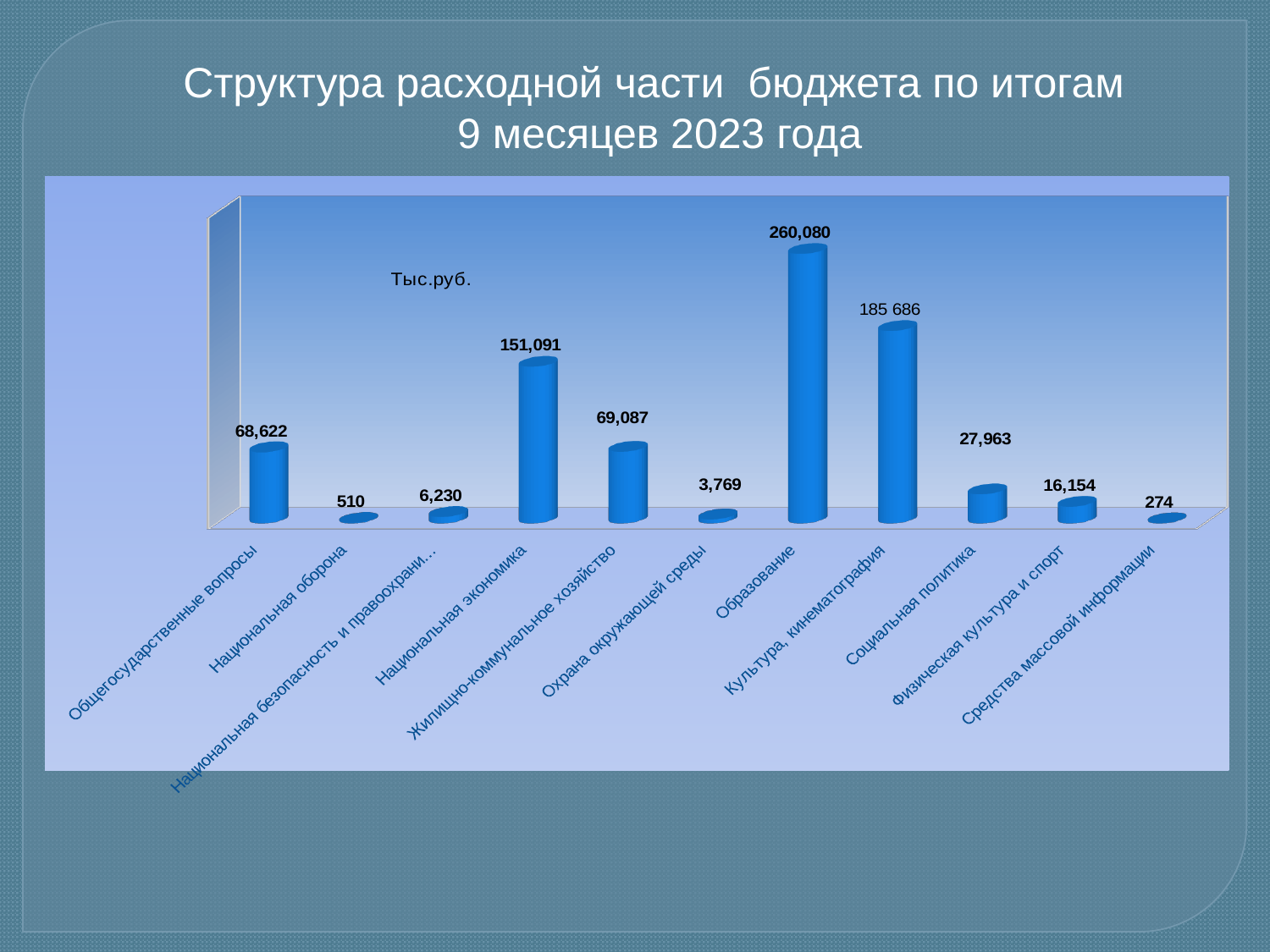
What kind of chart is shown on the slide? Bar chart Which category has the highest value? Образование What is the value for Средства массовой информации? 274 What is the value for Культура, кинематография? 185 686 What is the difference between the values for Образование and Культура, кинематография? 74,394 What is the difference between the values for Социальная политика and Физическая культура и спорт? 11,809 Which is larger, the value for Национальная экономика or the value for Жилищно-коммунальное хозяйство? Национальная экономика What is the value for Образование? 260,080 What is the value for Национальная экономика? 151,091 How many categories are shown in the chart? 11 What unit is indicated on the chart? Тыс.руб. Which category has the lowest value? Средства массовой информации